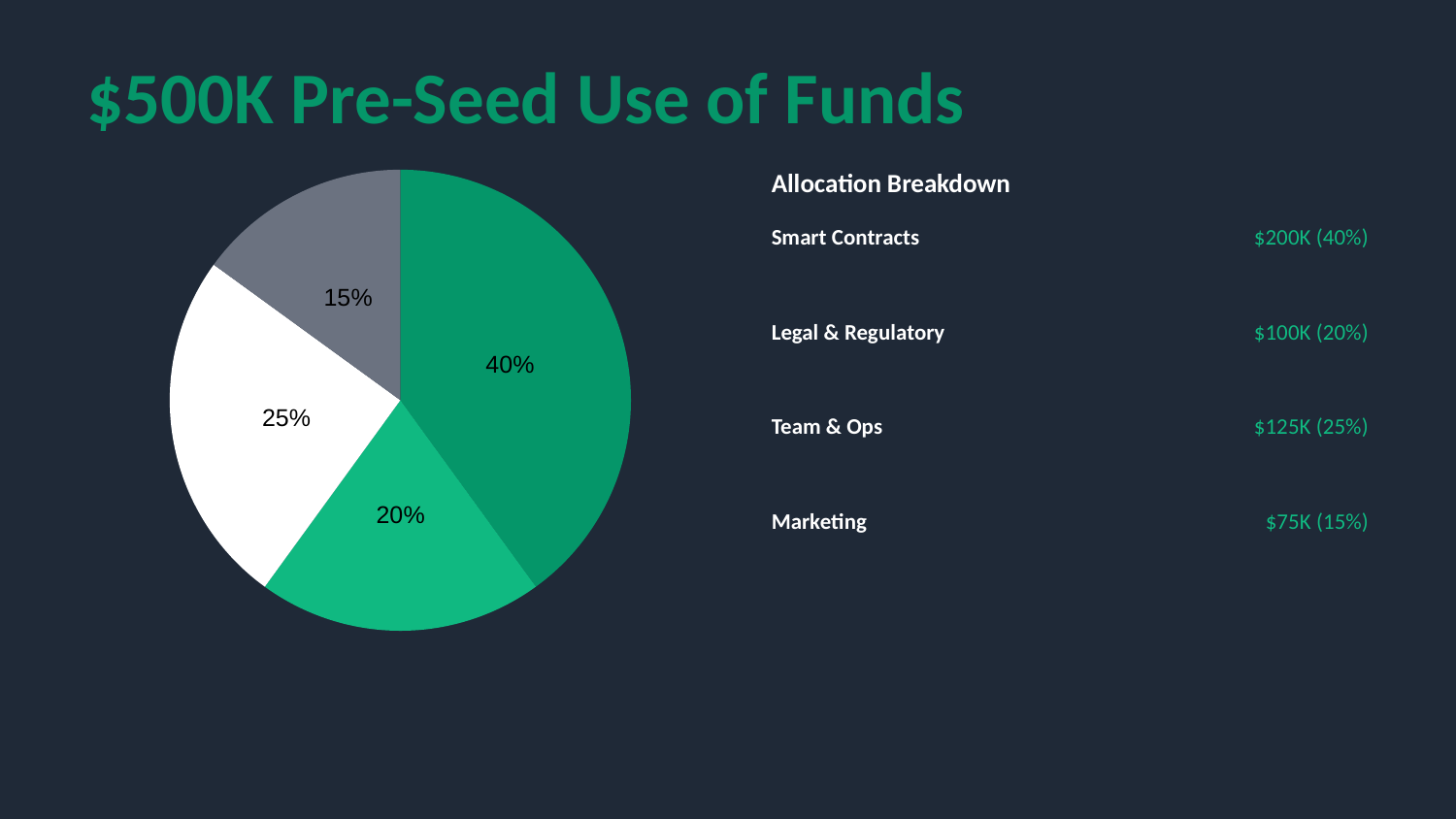
According to the allocation breakdown, which category corresponds to the 15% slice of the pie chart? Marketing What kind of chart is shown on the slide? Pie chart Which is larger in the pie chart: the Team & Ops slice or the Legal & Regulatory slice? Team & Ops What is the title of the slide containing the pie chart? $500K Pre-Seed Use of Funds What share of the pie does Team & Ops represent? 25% What share of the pie does Legal & Regulatory represent? 20% According to the allocation breakdown, which category corresponds to the 40% slice of the pie chart? Smart Contracts What colour is the 25% slice of the pie chart? White What is the difference in percentage points between the 40% slice and the 15% slice? 25 What percentage is shown on the largest slice of the pie chart? 40% What percentage is shown on the smallest slice of the pie chart? 15% How many slices does the pie chart have? 4